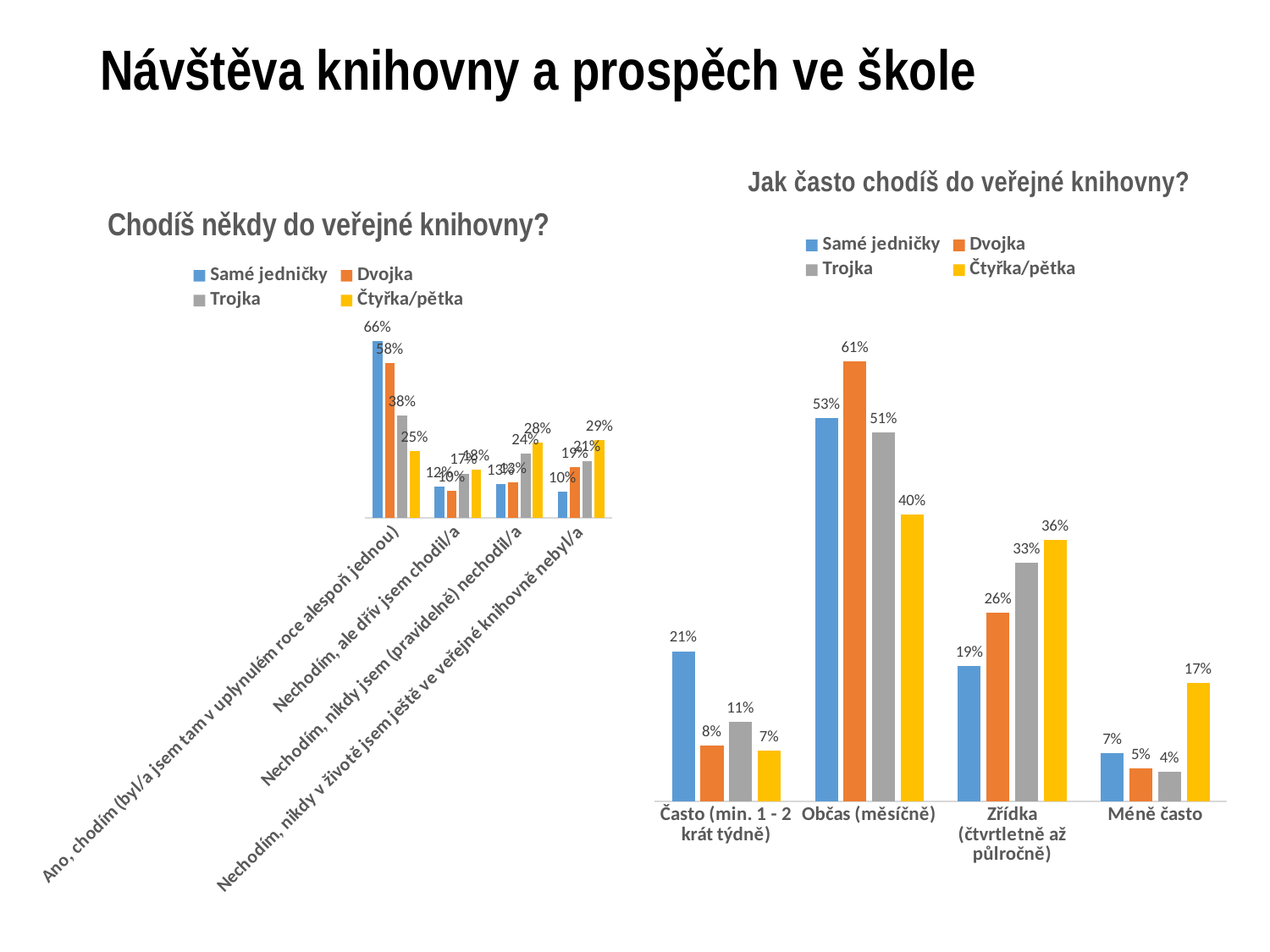
In the chart 'Jak často chodíš do veřejné knihovny?', which series has the lowest value in the category 'Méně často'? Trojka In the chart 'Jak často chodíš do veřejné knihovny?', which is larger in the category 'Občas (měsíčně)': Samé jedničky or Čtyřka/pětka? Samé jedničky What kind of chart is 'Chodíš někdy do veřejné knihovny?'? bar chart In the chart 'Chodíš někdy do veřejné knihovny?', what is the value for Samé jedničky in the category 'Ano, chodím (byl/a jsem tam v uplynulém roce alespoň jednou)'? 66% In the chart 'Jak často chodíš do veřejné knihovny?', what is the value for Dvojka in the category 'Občas (měsíčně)'? 61% In the chart 'Jak často chodíš do veřejné knihovny?', what is the value for Čtyřka/pětka in the category 'Méně často'? 17% In the chart 'Jak často chodíš do veřejné knihovny?', what is the difference between Samé jedničky and Čtyřka/pětka in the category 'Často (min. 1 - 2 krát týdně)'? 14% How many series does the legend of the chart 'Chodíš někdy do veřejné knihovny?' list? 4 In the chart 'Chodíš někdy do veřejné knihovny?', what is the difference between Samé jedničky and Čtyřka/pětka in the category 'Ano, chodím (byl/a jsem tam v uplynulém roce alespoň jednou)'? 41% How many categories are shown on the x axis of the chart 'Jak často chodíš do veřejné knihovny?'? 4 In the chart 'Jak často chodíš do veřejné knihovny?', which series has the highest value in the category 'Zřídka (čtvrtletně až půlročně)'? Čtyřka/pětka In the chart 'Chodíš někdy do veřejné knihovny?', which series has the highest value in the category 'Nechodím, nikdy v životě jsem ještě ve veřejné knihovně nebyl/a'? Čtyřka/pětka